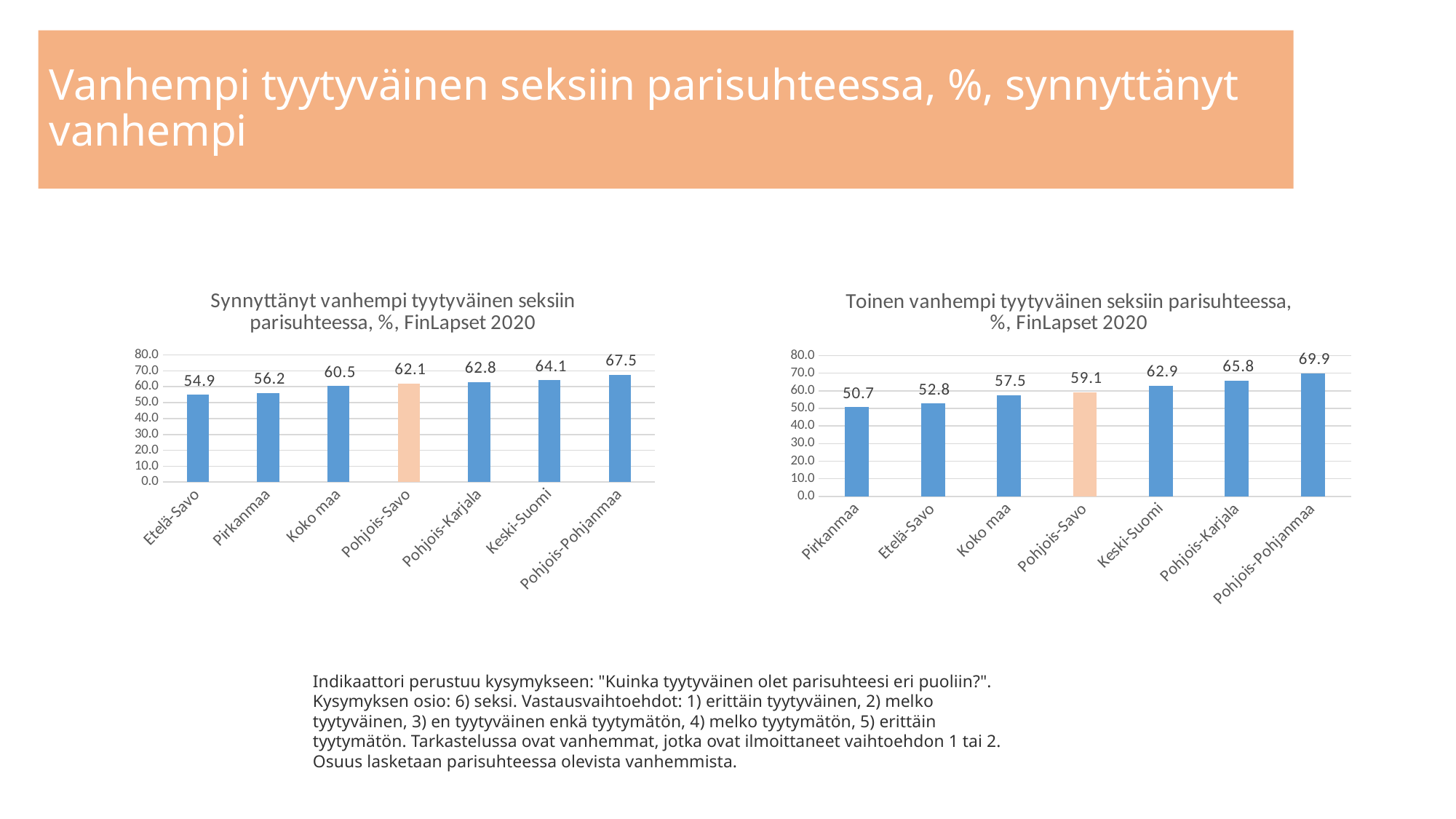
In the right chart, what is the difference between Pohjois-Savo and Koko maa? 1.6 In the left chart, which category has the highest value? Pohjois-Pohjanmaa In the right chart (Toinen vanhempi tyytyväinen seksiin parisuhteessa), what is the value for Koko maa? 57.5 In the right chart, which is larger: Keski-Suomi or Etelä-Savo? Keski-Suomi How many categories are shown in the right chart? 7 In the left chart, what is the difference between Pohjois-Pohjanmaa and Etelä-Savo? 12.6 In the right chart, which category has the lowest value? Pirkanmaa In the left chart (Synnyttänyt vanhempi tyytyväinen seksiin parisuhteessa), what is the value for Pohjois-Savo? 62.1 In the left chart, which category's bar is coloured differently (orange) from the others? Pohjois-Savo In the left chart, is the value for Keski-Suomi greater or less than 60.0? greater What kind of chart is the left chart? Bar chart In the right chart, do the values rise or fall from left to right along the x axis? Rise